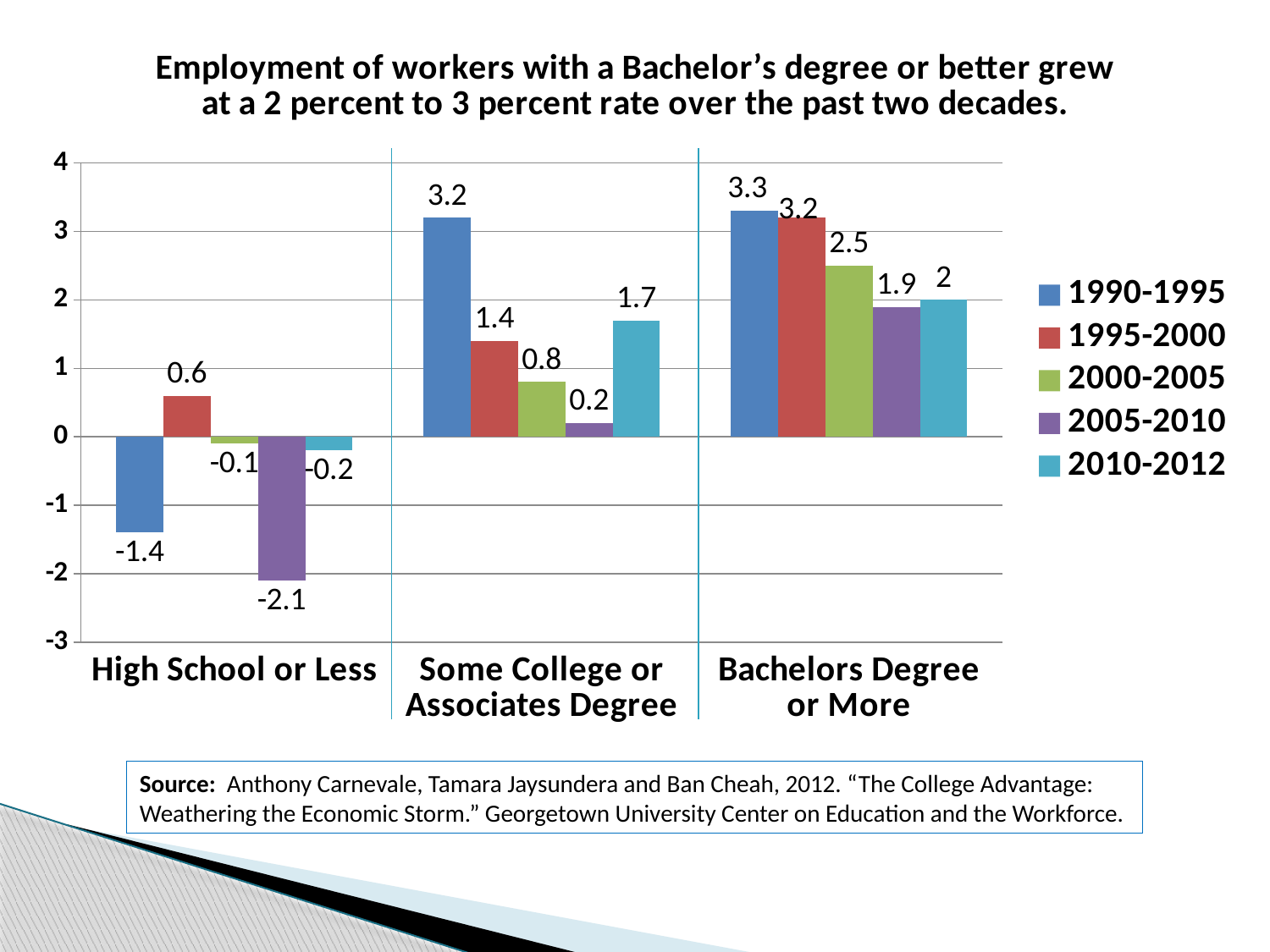
Which is larger in the Bachelors Degree or More category: the 2005-2010 value or the 2010-2012 value? 2010-2012 Which period has the highest value in the Bachelors Degree or More category? 1990-1995 Which legend entry is shown in red? 1995-2000 What is the value for 1990-1995 in the High School or Less category? -1.4 What is the value for 2000-2005 in the Bachelors Degree or More category? 2.5 What is the value for 2010-2012 in the Some College or Associates Degree category? 1.7 What is the difference between the 1990-1995 and 1995-2000 values in the Some College or Associates Degree category? 1.8 How many education categories are shown on the x axis? 3 What is the value for 2005-2010 in the Some College or Associates Degree category? 0.2 Which period has the lowest value in the High School or Less category? 2005-2010 What kind of chart is shown on the slide? bar chart How many series does the legend list? 5